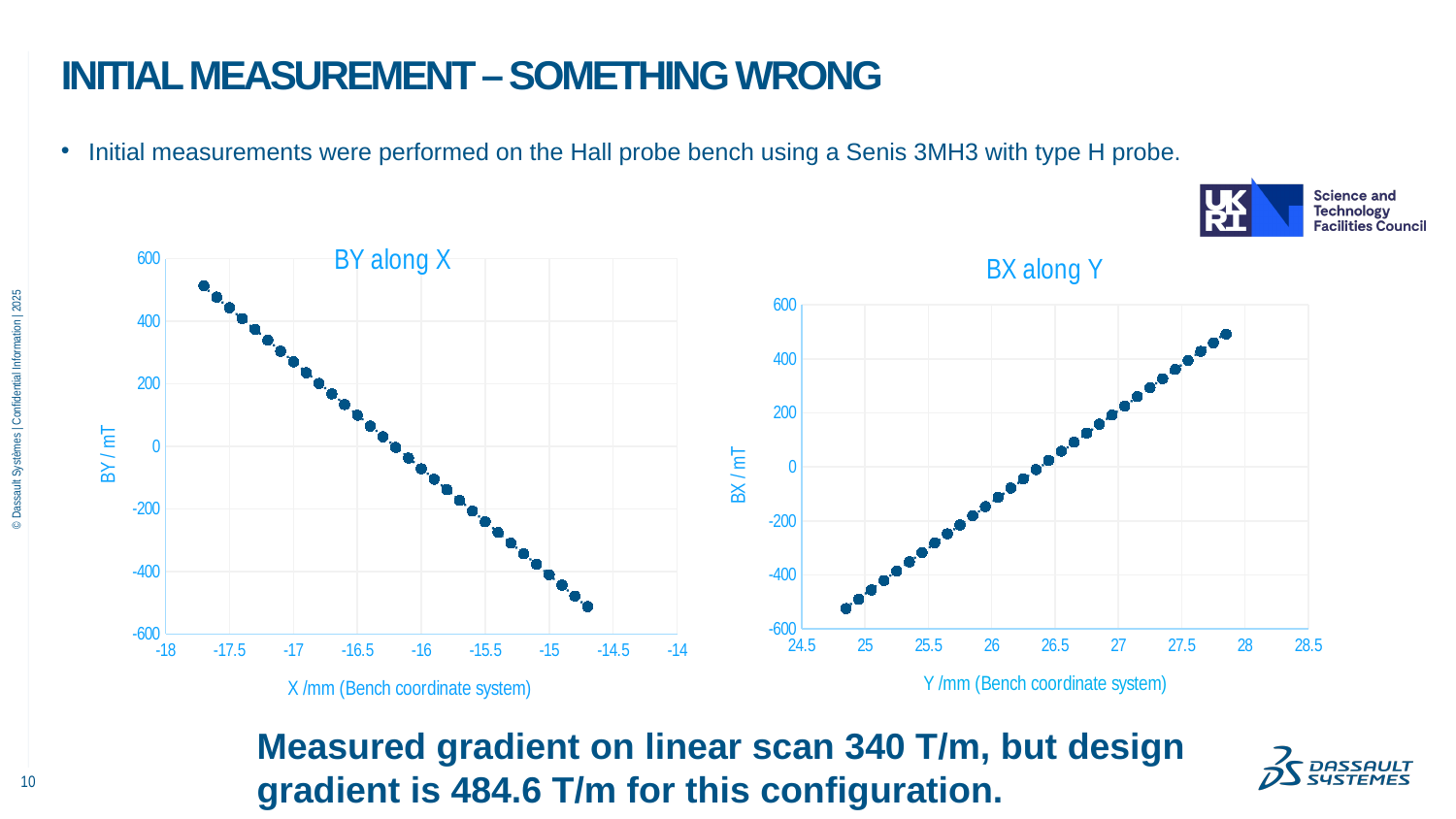
What is the x-axis label of the 'BY along X' chart? X /mm (Bench coordinate system) In the 'BY along X' chart, is the value at X = -15.5 greater or less than -400? greater In the 'BX along Y' chart, is the value at Y = 25 greater or less than -400? less What kind of chart is the 'BY along X' chart? scatter chart In the 'BY along X' chart, which is larger: the value at X = -17 or the value at X = -15? the value at X = -17 In the 'BX along Y' chart, do the values rise or fall as Y increases? rise In the 'BY along X' chart, do the values rise or fall as X increases? fall In the 'BX along Y' chart, is the value at Y = 27 greater or less than 0? greater In the 'BX along Y' chart, which is larger: the value at Y = 25.5 or the value at Y = 27.5? the value at Y = 27.5 What kind of chart is the 'BX along Y' chart? scatter chart What is the y-axis label of the 'BX along Y' chart? BX / mT